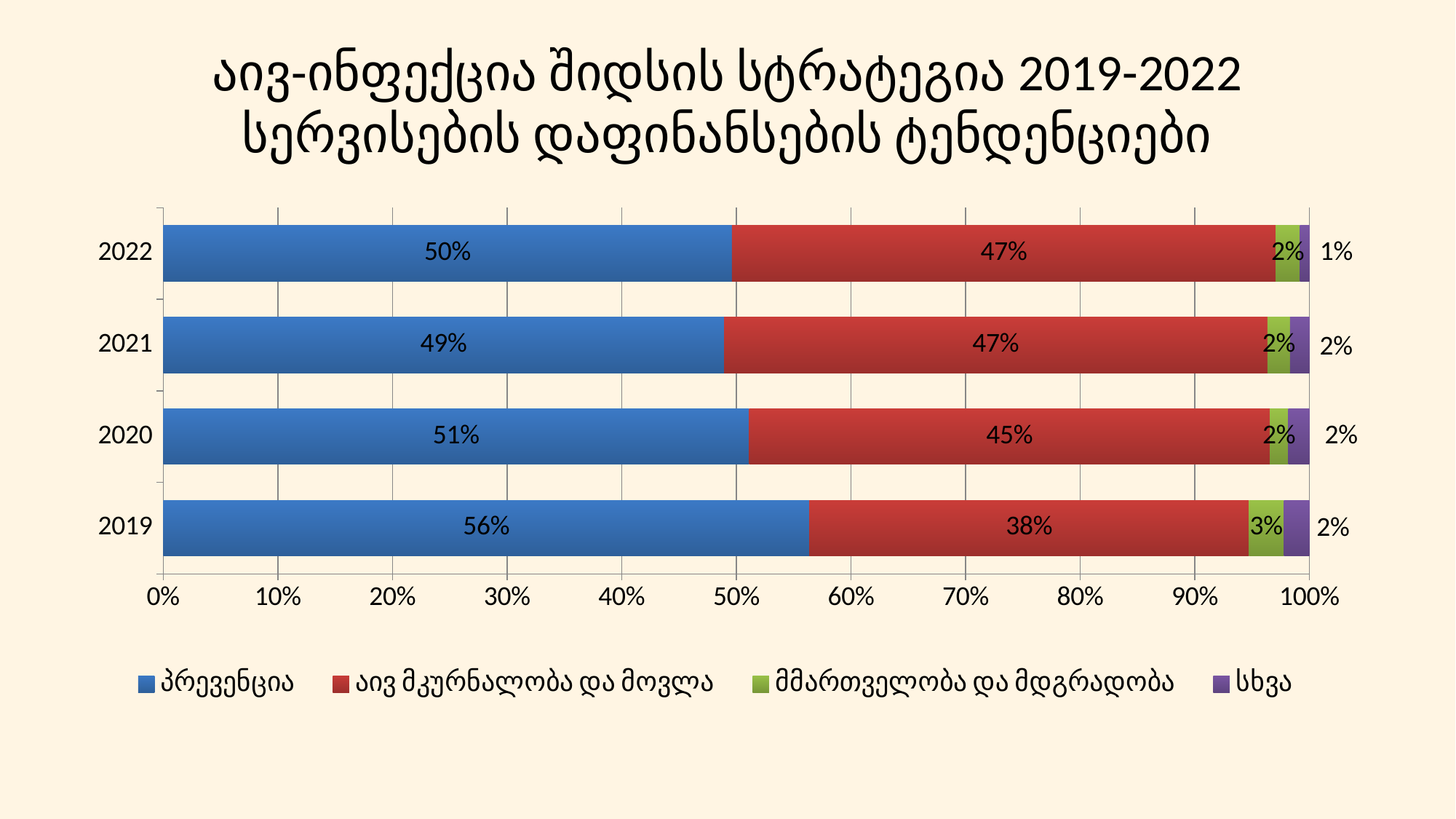
What is the difference between the პრევენცია values for 2019 and 2022? 6% Which colour represents სხვა in the chart? Purple Which is larger in 2020: პრევენცია or აივ მკურნალობა და მოვლა? პრევენცია How many years are shown on the chart? 4 In which year is the value for პრევენცია highest? 2019 In which year is the value for აივ მკურნალობა და მოვლა lowest? 2019 What is the value for სხვა in 2022? 1% How many series does the legend list? 4 What is the value for პრევენცია in 2019? 56% What is the value for აივ მკურნალობა და მოვლა in 2022? 47% What is the value for მმართველობა და მდგრადობა in 2019? 3% What kind of chart is shown on the slide? Stacked bar chart